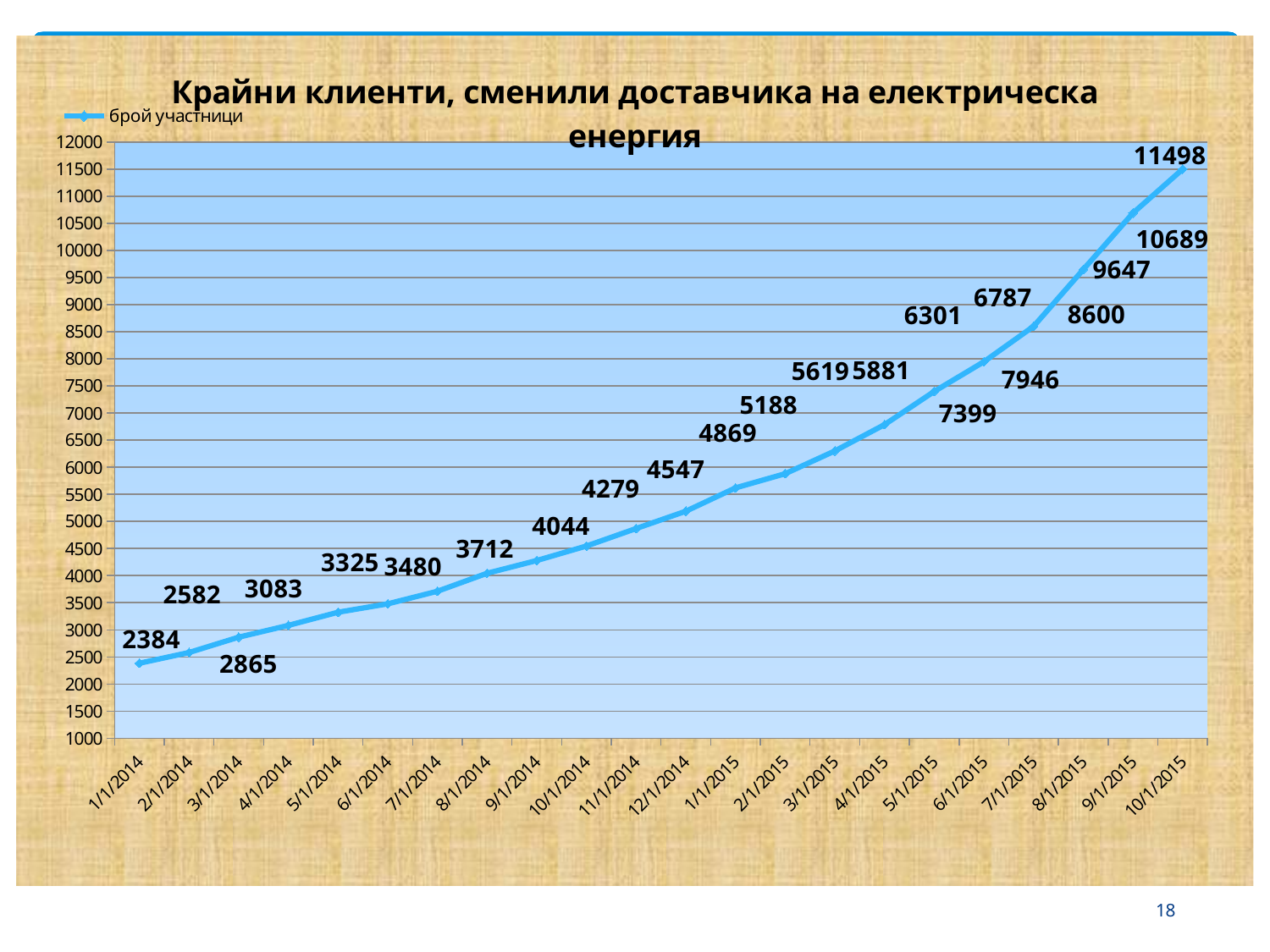
How many series does the legend list? 1 What is the value for 6/1/2015? 7946 Do the values rise or fall from 1/1/2014 to 10/1/2015? rise What is the value for 10/1/2015? 11498 Which date has the lowest value? 1/1/2014 Which is larger, the value for 12/1/2014 or the value for 2/1/2015? 2/1/2015 What is the value for 1/1/2014? 2384 Which date has the highest value? 10/1/2015 How many data points are plotted on the chart? 22 What kind of chart is shown? line chart What is the value for 1/1/2015? 5619 What is the difference between the values for 10/1/2015 and 9/1/2015? 809